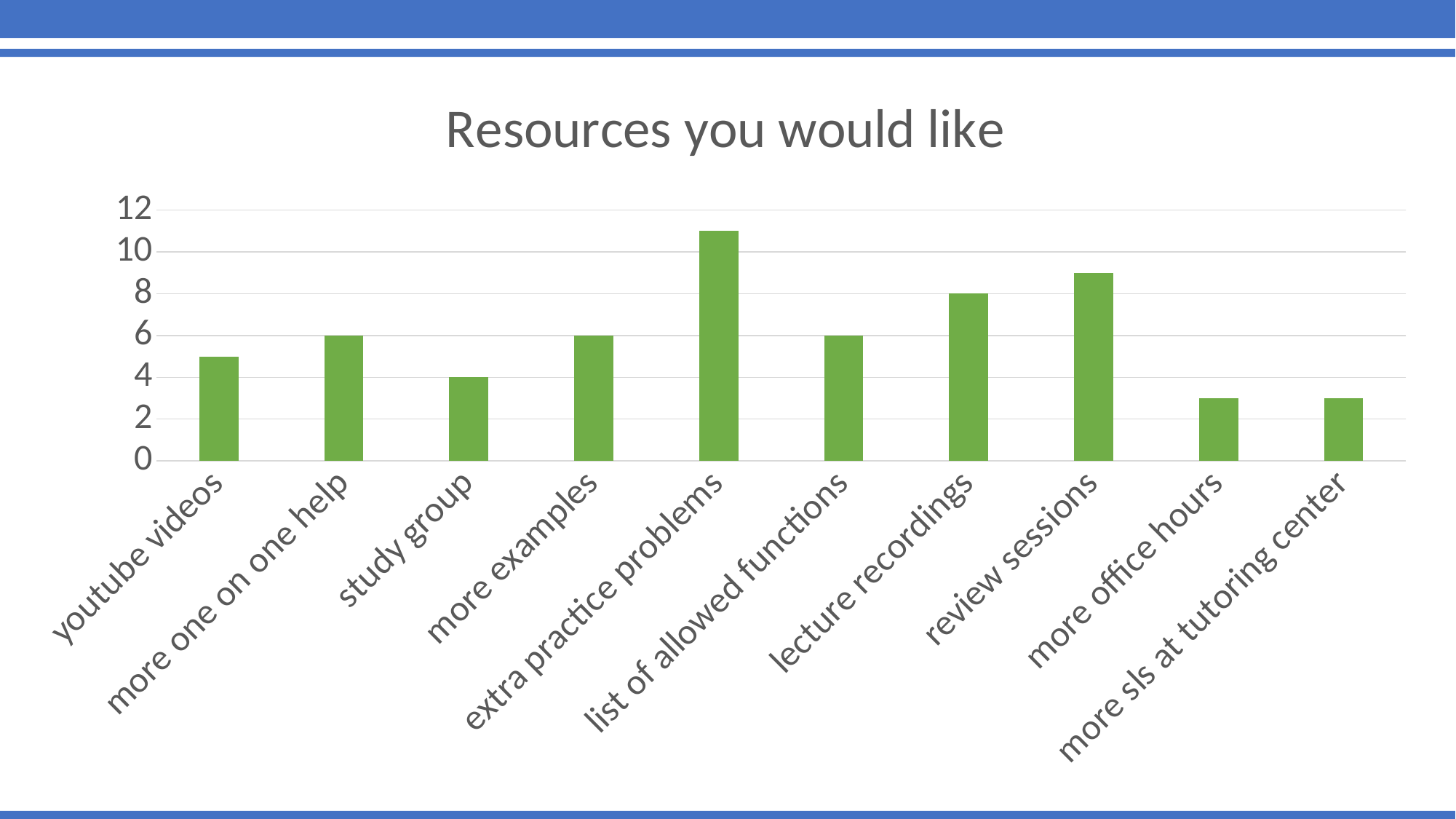
Which is larger, the value for lecture recordings or the value for more examples? lecture recordings What is the difference between the values for lecture recordings and study group? 4 Which resource has the highest value? extra practice problems Is the value for review sessions greater or less than 8? greater Is the value for extra practice problems greater or less than 10? greater What is the value for lecture recordings? 8 Is the value for more office hours greater or less than 4? less What kind of chart is shown on the slide? bar chart How many resource categories are shown on the chart? 10 What is the title of the chart? Resources you would like What is the value for more one on one help? 6 What is the value for study group? 4